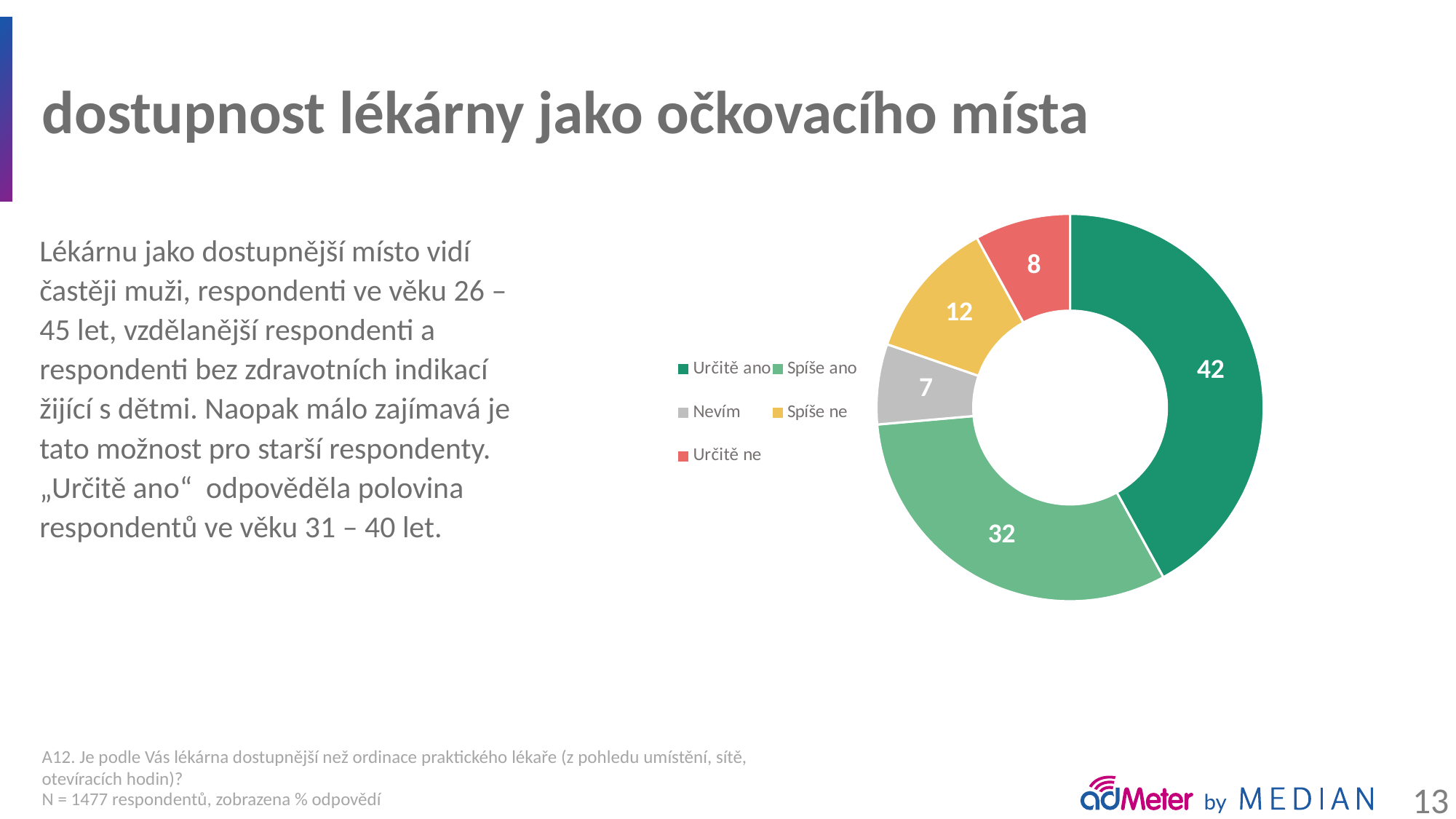
How many categories does the legend list? 5 What kind of chart is shown on the slide? Doughnut (pie) chart What is the value for "Nevím"? 7 Which category has the smallest share of the chart? Nevím What is the value for "Určitě ne"? 8 What is the difference between the values for "Určitě ano" and "Spíše ano"? 10 Which is larger, the value for "Spíše ne" or the value for "Určitě ne"? Spíše ne What is the value for "Spíše ne"? 12 What is the value for "Spíše ano"? 32 Which category has the largest share of the chart? Určitě ano What colour is the "Nevím" slice? Grey What is the value for "Určitě ano"? 42